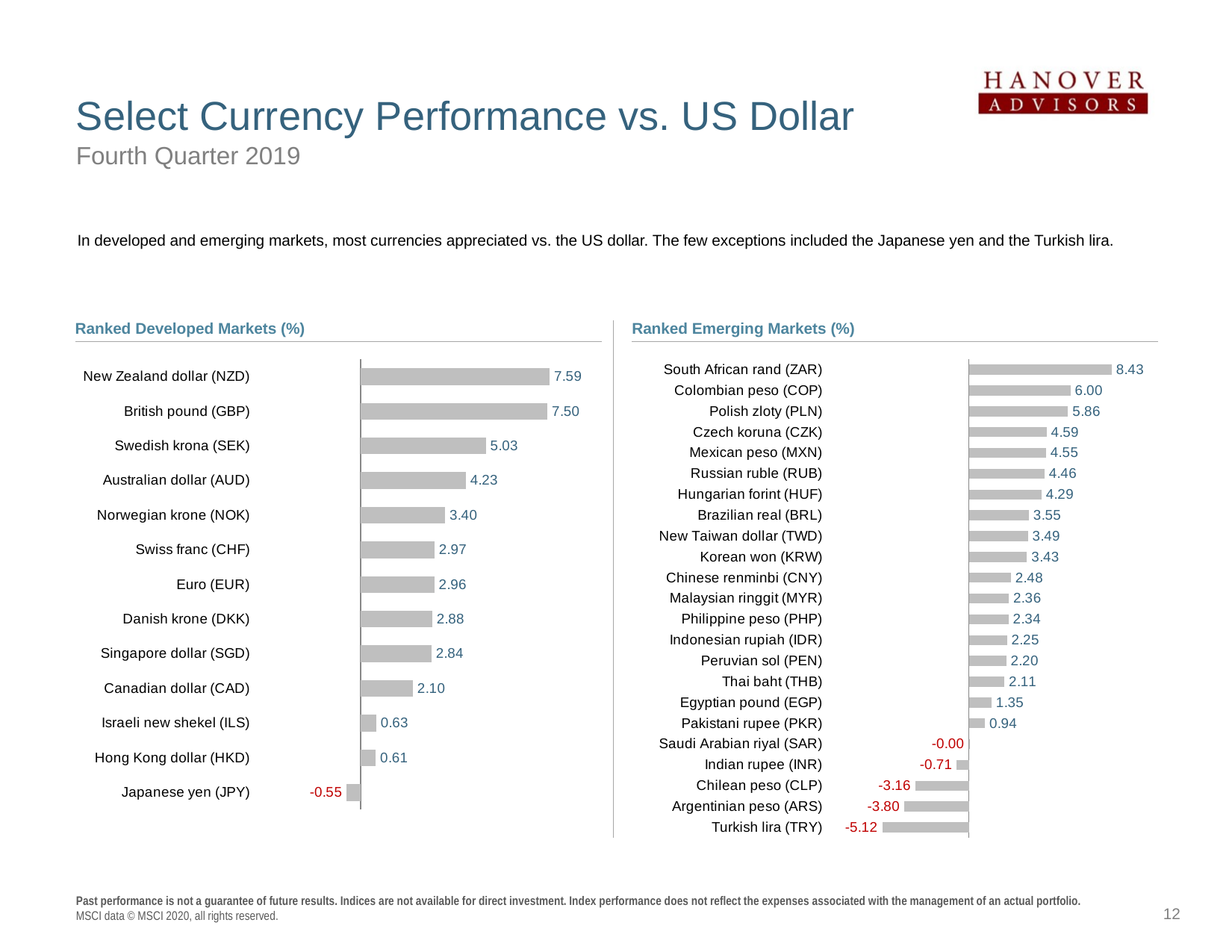
In the Ranked Emerging Markets (%) chart, what is the value for the Indian rupee (INR)? -0.71 What kind of chart is the Ranked Emerging Markets (%) chart? Bar chart In the Ranked Emerging Markets (%) chart, what is the value for the Brazilian real (BRL)? 3.55 How many currencies are shown in the Ranked Emerging Markets (%) chart? 23 In the Ranked Developed Markets (%) chart, what is the value for the Swedish krona (SEK)? 5.03 In the Ranked Developed Markets (%) chart, which currency has the highest value? New Zealand dollar (NZD) How many currencies are shown in the Ranked Developed Markets (%) chart? 13 In the Ranked Emerging Markets (%) chart, which currency has the lowest value? Turkish lira (TRY) In the Ranked Developed Markets (%) chart, what is the difference between the New Zealand dollar (NZD) and the British pound (GBP)? 0.09 In the Ranked Emerging Markets (%) chart, what is the difference between the South African rand (ZAR) and the Colombian peso (COP)? 2.43 In the Ranked Developed Markets (%) chart, which currency has a negative value? Japanese yen (JPY) In the Ranked Emerging Markets (%) chart, which is larger, the Mexican peso (MXN) or the Hungarian forint (HUF)? Mexican peso (MXN)